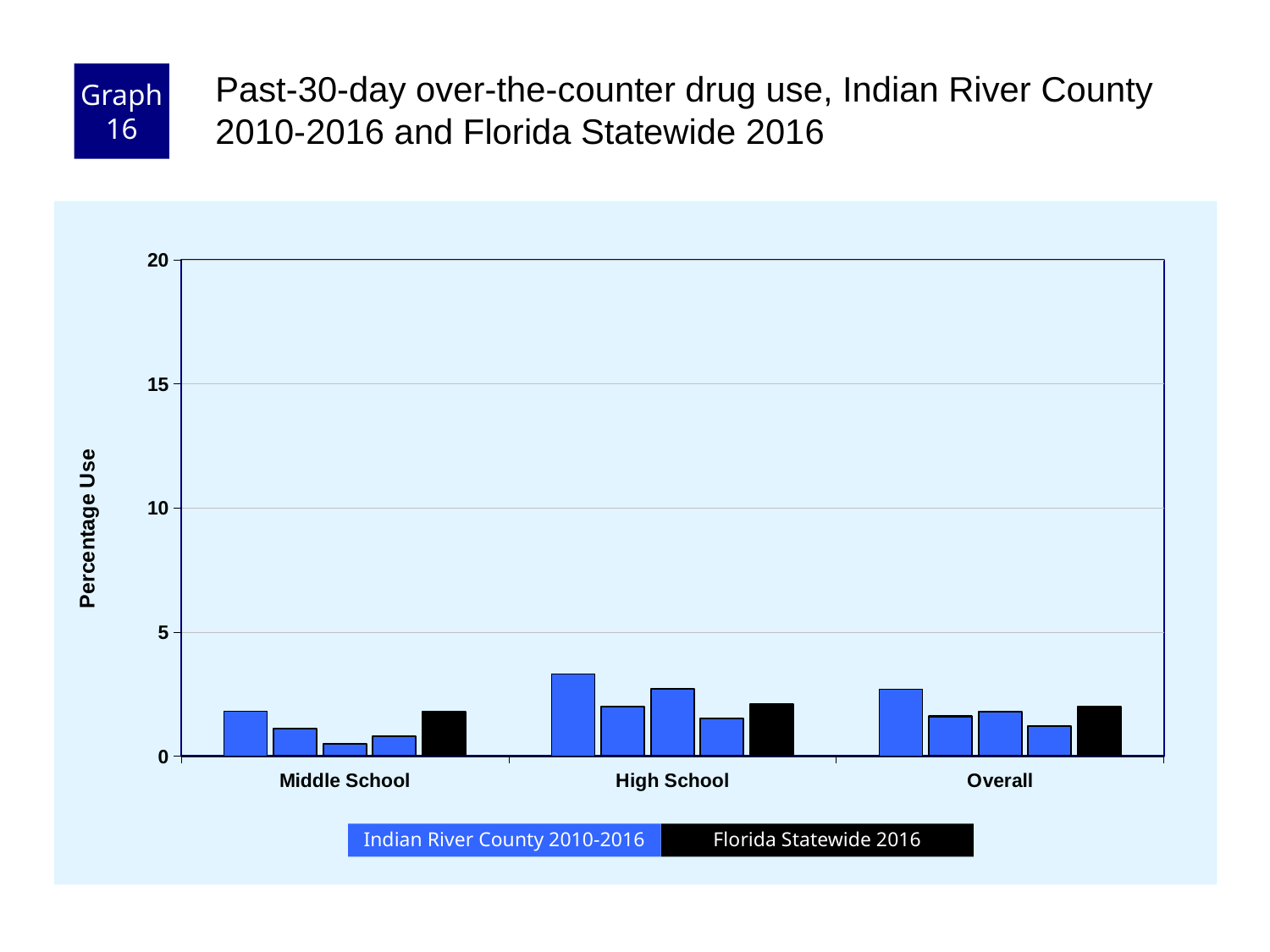
Is the tallest Indian River County bar for High School greater or less than 5? less Which category contains the shortest bar on the chart? Middle School Is the Florida Statewide 2016 value for Middle School greater or less than 5? less What is the title of the y axis? Percentage Use How many series does the legend list? 2 What kind of chart is shown on the slide? bar chart In the Middle School group, which is larger: the Florida Statewide 2016 bar or the shortest Indian River County bar? Florida Statewide 2016 In the High School group, which is larger: the first Indian River County bar or the Florida Statewide 2016 bar? the first Indian River County bar Is the Florida Statewide 2016 value for High School greater or less than 5? less Which colour represents Florida Statewide 2016 in the legend? black How many categories are shown on the x axis? 3 Which category contains the tallest bar on the chart? High School